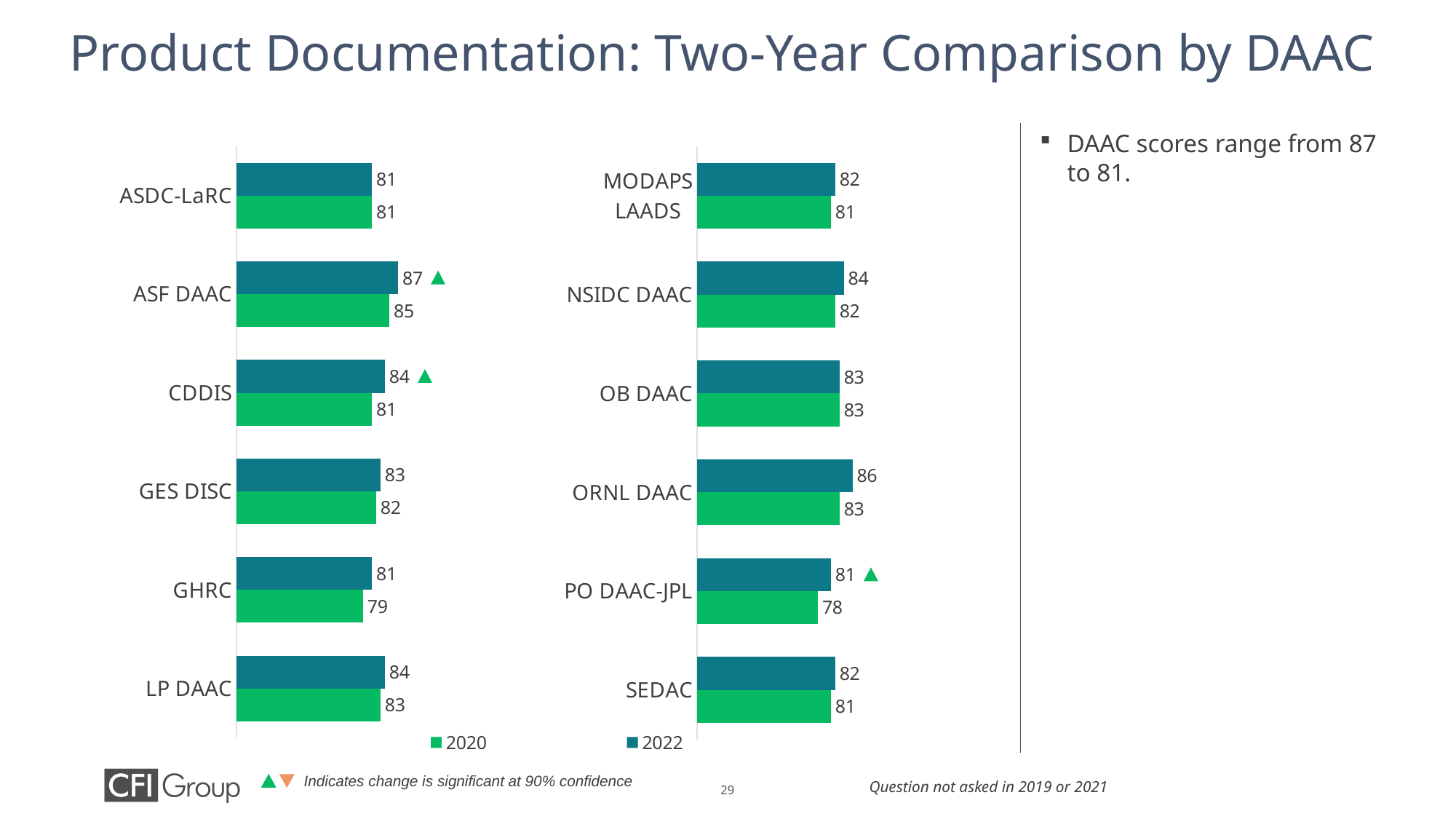
In the left chart, what is the difference between the 2022 and 2020 values for CDDIS? 3 In the left chart, what is the 2022 value for ASF DAAC? 87 In the right chart, what is the difference between the 2022 and 2020 values for NSIDC DAAC? 2 How many series does the legend list? 2 In the right chart, what is the 2020 value for PO DAAC-JPL? 78 In the right chart, what is the 2022 value for ORNL DAAC? 86 How many DAACs are shown in the left chart? 6 In the right chart, which DAAC has the lowest 2020 value? PO DAAC-JPL What type of chart is used on this slide? Bar chart In the left chart, what is the 2020 value for GHRC? 79 In the right chart, which is larger for ORNL DAAC, the 2022 value or the 2020 value? 2022 In the left chart, which DAAC has the highest 2022 value? ASF DAAC